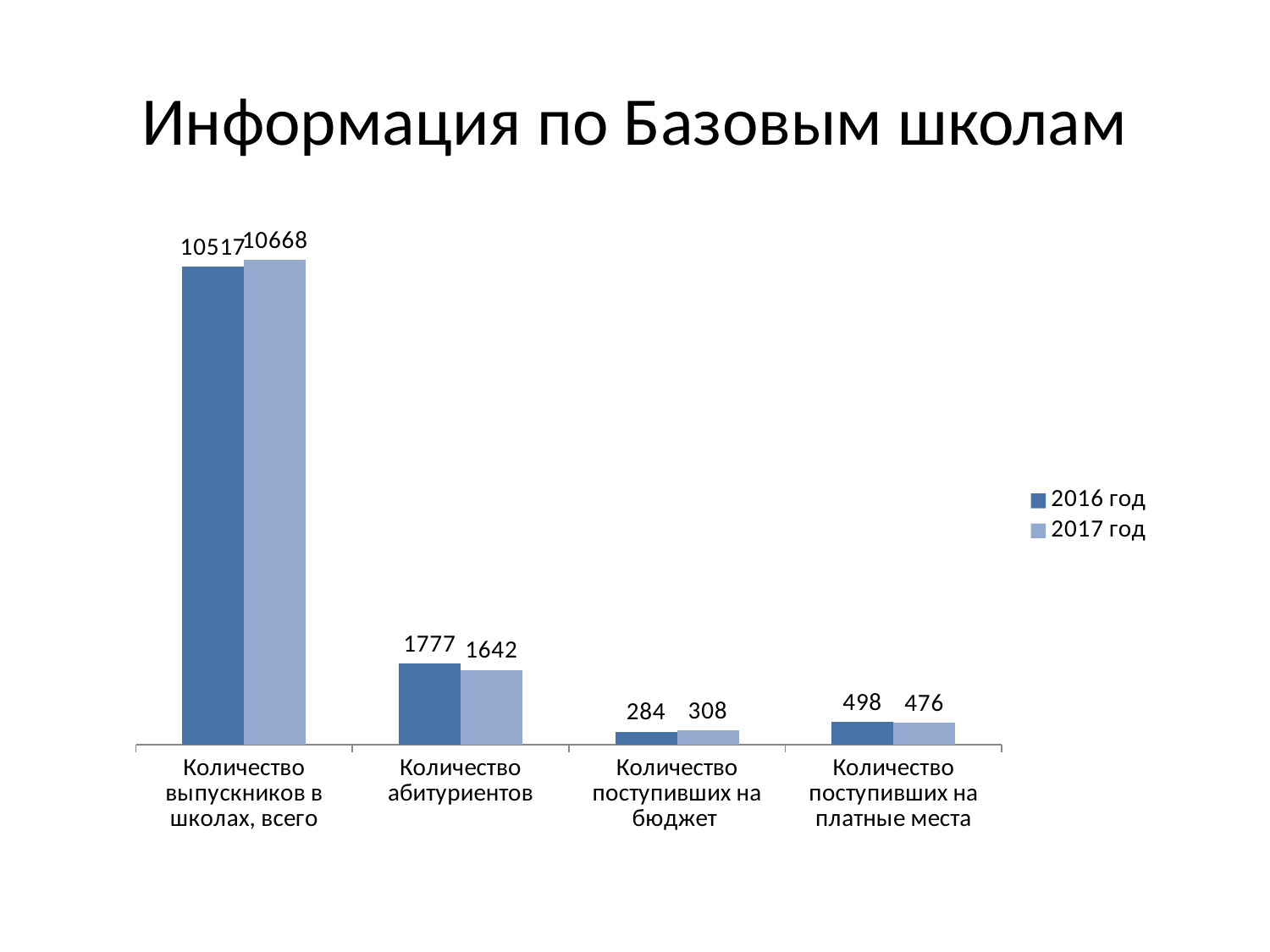
What kind of chart is shown on the slide? Bar chart Which category has the lowest value for 2016 год? Количество поступивших на бюджет What is the difference between the 2016 год and 2017 год values for Количество абитуриентов? 135 How many series does the legend list? 2 What is the value for 2016 год for Количество поступивших на бюджет? 284 What is the value for 2016 год for Количество выпускников в школах, всего? 10517 Which category has the highest value for 2017 год? Количество выпускников в школах, всего What is the value for 2017 год for Количество поступивших на платные места? 476 What is the value for 2017 год for Количество абитуриентов? 1642 How many categories are shown on the x axis? 4 Which is larger for Количество поступивших на бюджет: the 2016 год value or the 2017 год value? 2017 год What is the difference between the 2017 год and 2016 год values for Количество выпускников в школах, всего? 151